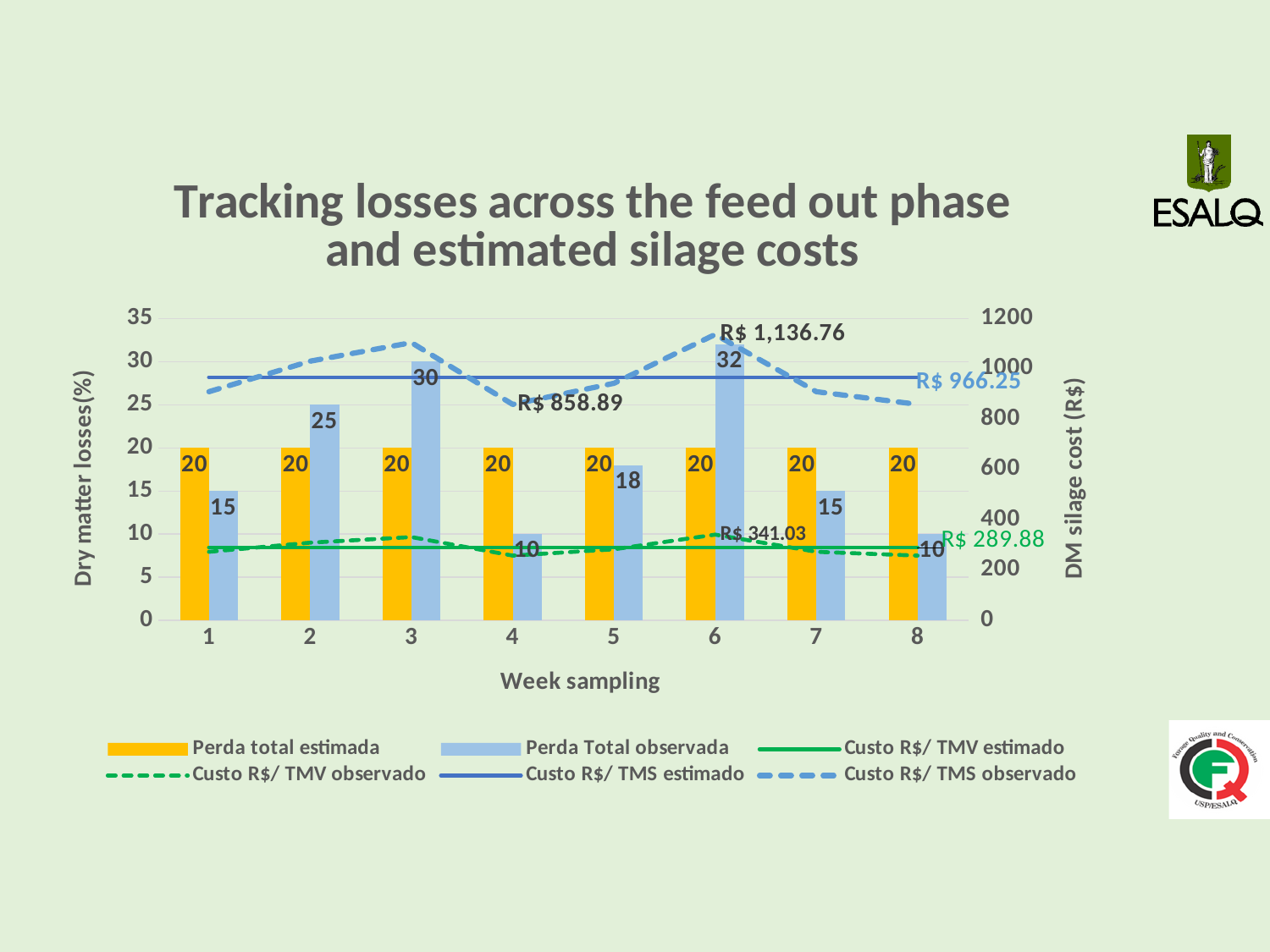
What is the difference between Perda Total observada and Perda total estimada at week 6? 12 Which week has the highest Perda Total observada? 6 How many weeks are shown on the x axis? 8 What is the labelled value of Custo R$/ TMS observado at week 6? R$ 1,136.76 What is the value of Perda total estimada at week 5? 20 How many series does the legend list? 6 At week 2, which is larger: Perda total estimada or Perda Total observada? Perda Total observada What kind of chart is this? Combined bar and line chart What is the labelled value of the Custo R$/ TMS estimado line? R$ 966.25 What is the value of Perda Total observada at week 3? 30 What is the value of Perda Total observada at week 6? 32 What is the title of the x axis? Week sampling